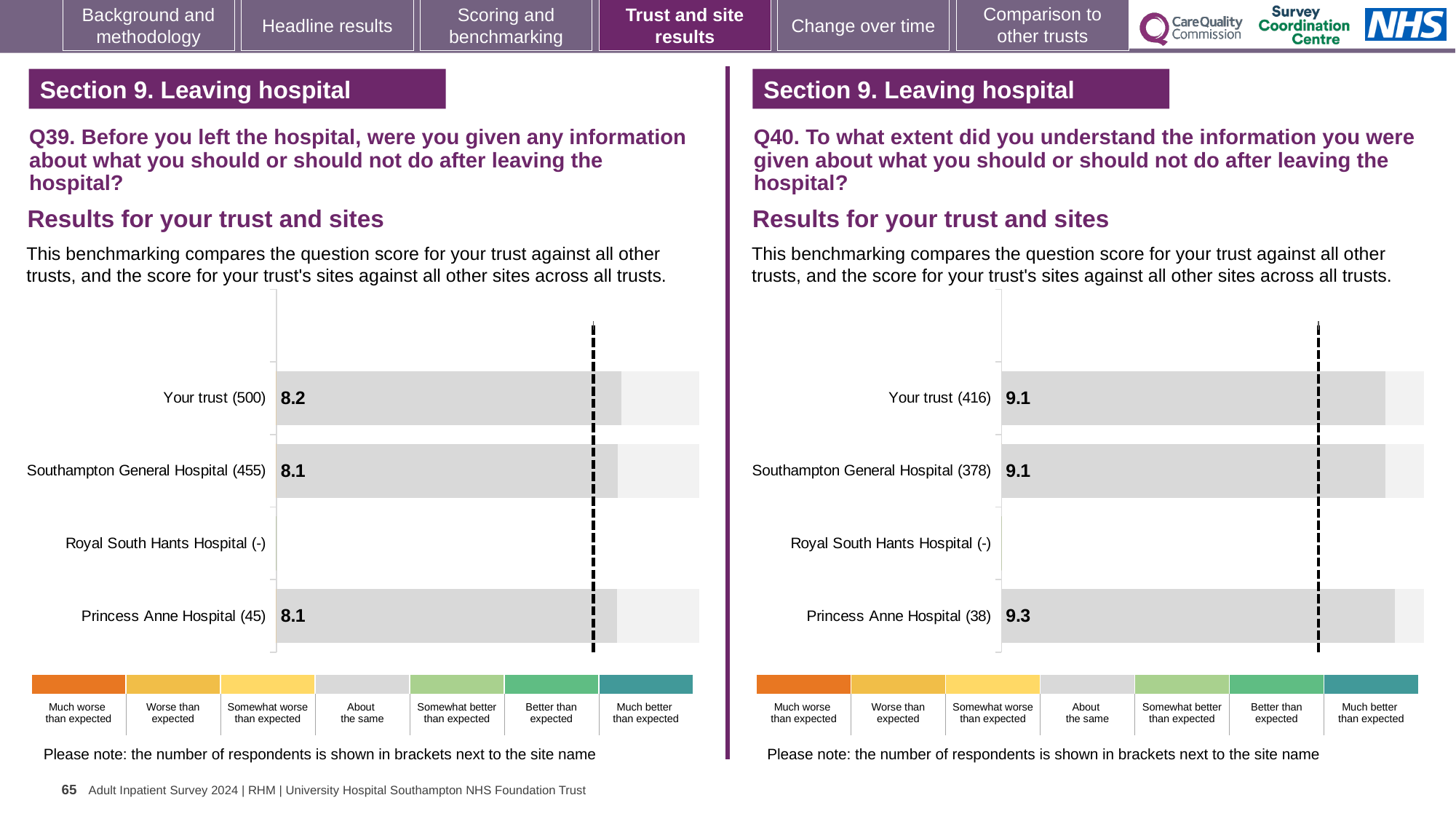
In the Q39 chart on the left, how many respondents are shown in brackets for Your trust? 500 In the Q40 chart on the right, what is the score for Southampton General Hospital? 9.1 In the Q39 chart on the left, what is the score for Princess Anne Hospital? 8.1 In the Q40 chart on the right, which has the larger score: Princess Anne Hospital or Southampton General Hospital? Princess Anne Hospital In the Q40 chart on the right, what is the difference between the scores for Princess Anne Hospital and Your trust? 0.2 In the Q39 chart on the left, which row has the highest score? Your trust In the Q39 chart on the left, what is the difference between the scores for Your trust and Southampton General Hospital? 0.1 In the Q39 chart on the left, what is the score for Your trust? 8.2 How many rows (trust and sites) are listed in the Q39 chart on the left? 4 In the Q40 chart on the right, which site or trust has the highest score? Princess Anne Hospital In the Q40 chart on the right, what is the score for Princess Anne Hospital? 9.3 What type of chart is used for the Q40 results on the right? Bar chart